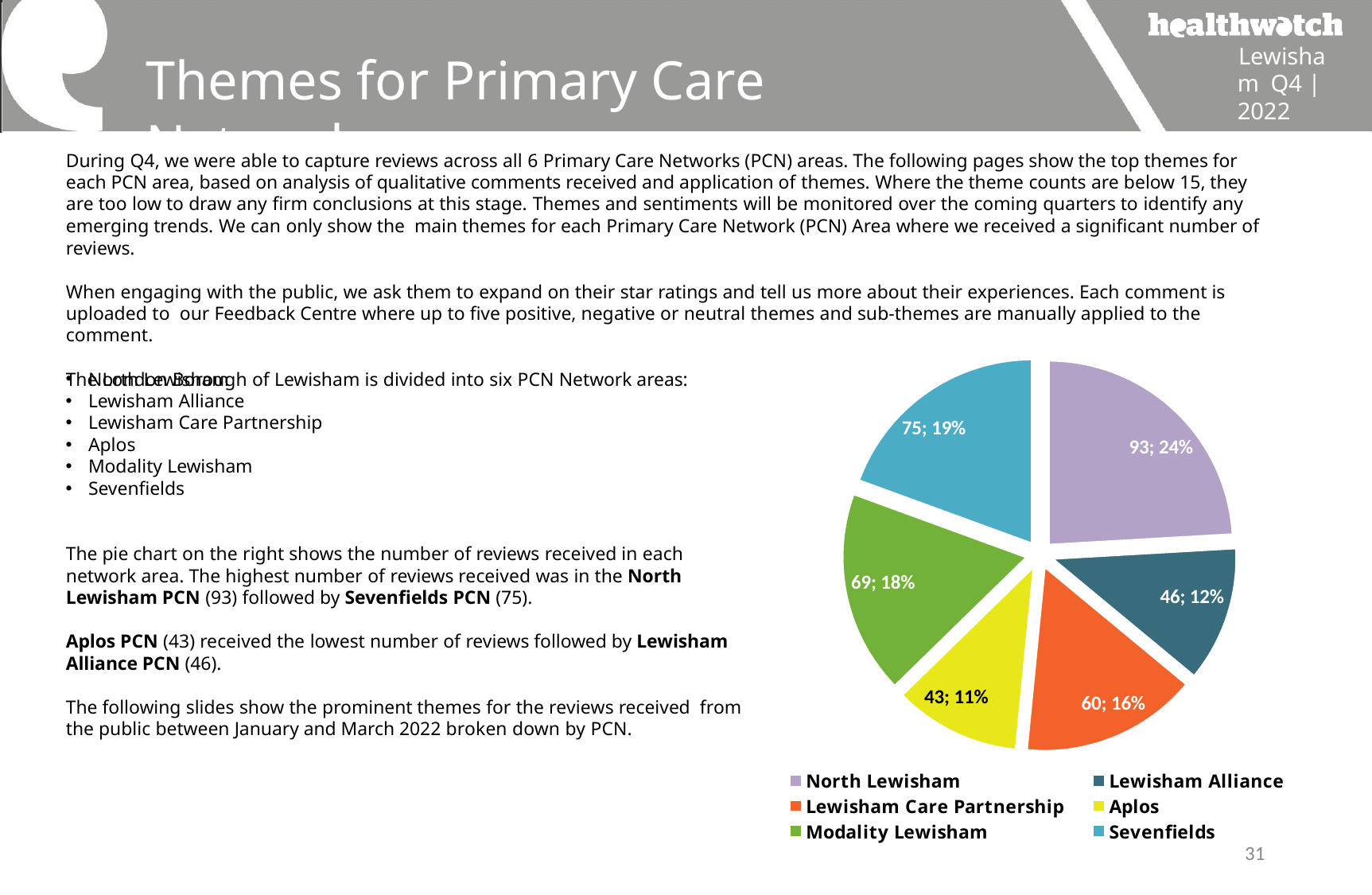
How many slices does the pie chart have? 6 Which has more reviews in the pie chart, Modality Lewisham or Lewisham Alliance? Modality Lewisham What percentage share does Aplos have in the pie chart? 11% What is the number of reviews for Lewisham Care Partnership in the pie chart? 60 What kind of chart is shown on the slide? pie chart What colour is the Lewisham Care Partnership slice in the pie chart? orange How many entries does the pie chart's legend list? 6 Which PCN area has the smallest slice in the pie chart? Aplos What percentage share does Sevenfields have in the pie chart? 19% Which PCN area has the largest slice in the pie chart? North Lewisham What is the difference in the number of reviews between North Lewisham and Sevenfields in the pie chart? 18 What is the number of reviews for North Lewisham in the pie chart? 93